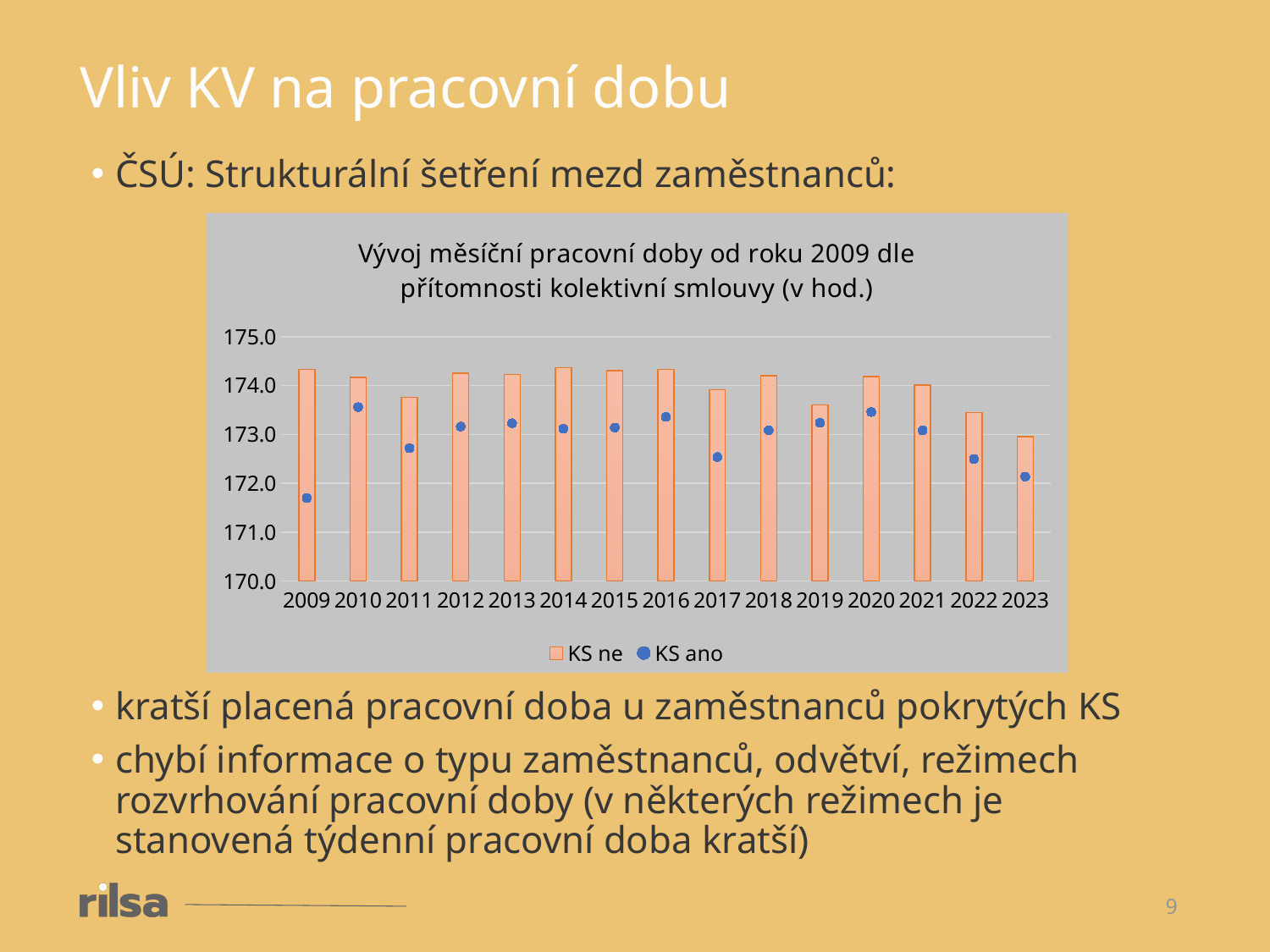
Is the KS ano value for 2017 greater or less than 173.0? less Is the KS ne value for 2009 greater or less than 174.0? greater How many series does the chart legend list? 2 Is the KS ano value for 2009 greater or less than 172.0? less In 2009, which is larger: the KS ne value or the KS ano value? KS ne What is the title of the chart? Vývoj měsíční pracovní doby od roku 2009 dle přítomnosti kolektivní smlouvy (v hod.) What are the two series named in the chart legend? KS ne and KS ano In which year is the KS ne bar the lowest? 2023 How many years are shown on the x axis of the chart? 15 What kind of chart is used to show the KS ne series? bar chart In which year is the KS ano value the lowest? 2009